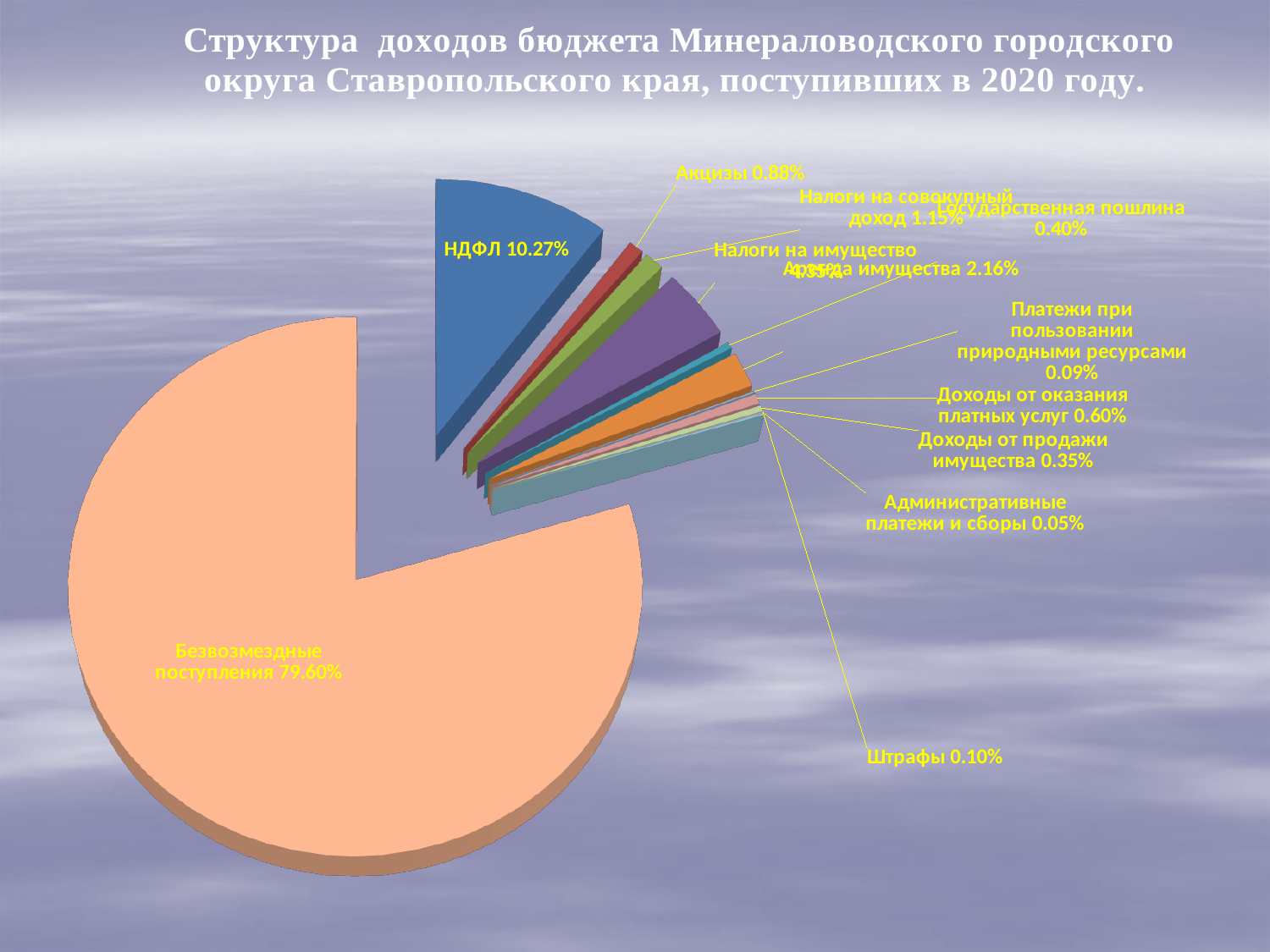
Which category has the smallest share of the pie? Административные платежи и сборы How many categories (slices) does the pie chart have? 12 What is the value shown for НДФЛ? 10.27% What is the value shown for Аренда имущества? 2.16% Which year does the chart title say the budget revenues were received in? 2020 What is the difference between the shares of Безвозмездные поступления and НДФЛ? 69.33% What share of the budget revenue is Безвозмездные поступления? 79.60% What is the value shown for Доходы от оказания платных услуг? 0.60% What kind of chart is shown on the slide? pie chart Which is larger, Акцизы or Налоги на совокупный доход? Налоги на совокупный доход What is the value shown for Штрафы? 0.10% Which category has the largest share of the pie? Безвозмездные поступления